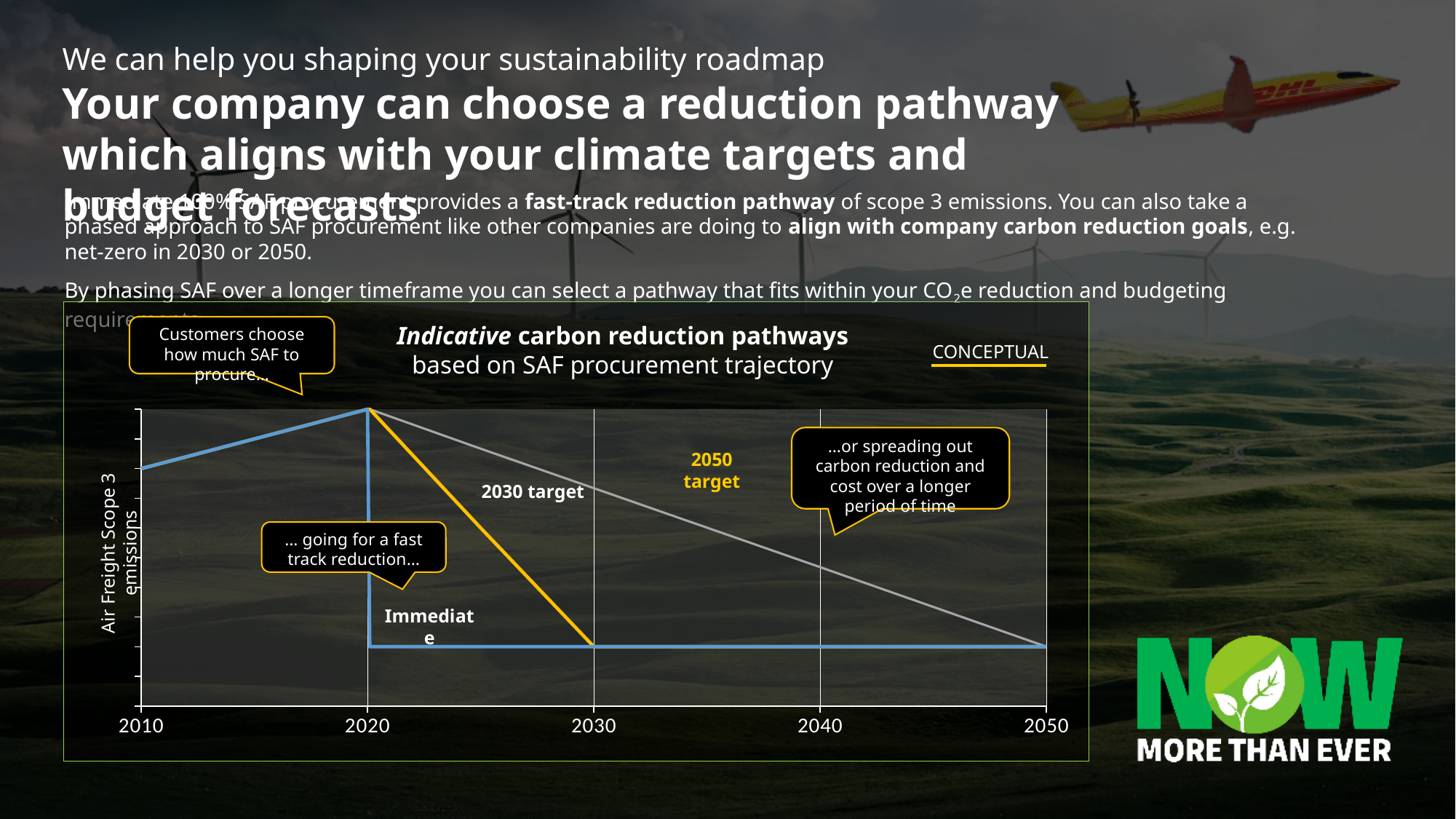
What is the title of the chart? Indicative carbon reduction pathways based on SAF procurement trajectory Which pathway reaches the lowest emissions level first? Immediate What is the label on the vertical axis of the chart? Air Freight Scope 3 emissions In which year does the '2050 target' pathway reach the lowest emissions level? 2050 Do emissions rise or fall along the '2050 target' pathway between 2020 and 2050? Fall What kind of chart is shown on the slide? Line chart In which year do all three pathways start to diverge? 2020 Do emissions rise or fall between 2010 and 2020 on the chart? Rise Which pathway is higher in 2040: the '2030 target' pathway or the '2050 target' pathway? 2050 target In which year does the '2030 target' pathway reach the lowest emissions level? 2030 How many year labels are shown on the x axis of the chart? 5 How many reduction pathways are plotted on the chart? 3